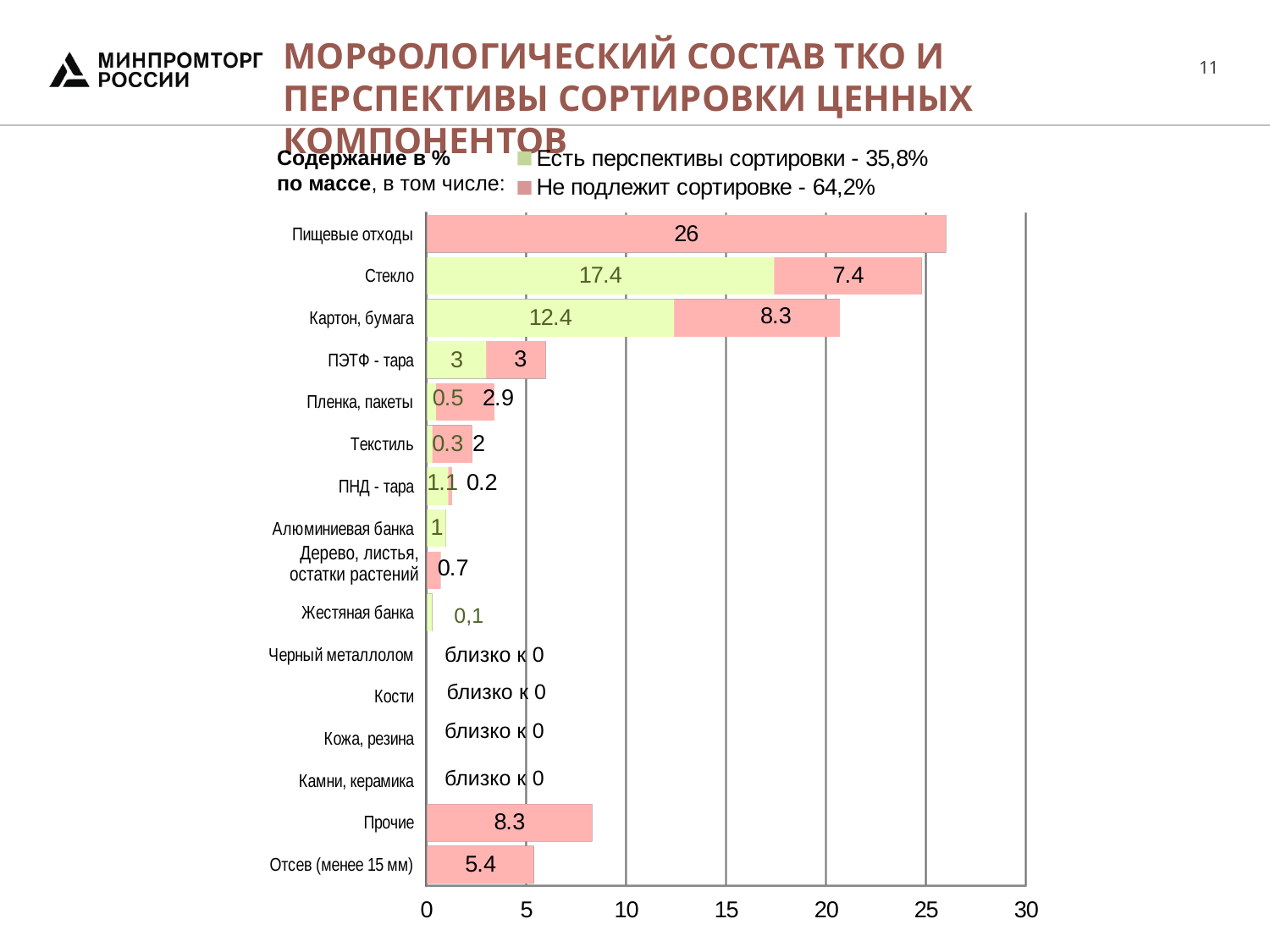
What percentage is shown in the legend for the Не подлежит сортировке series? 64,2% What is the value for Стекло in the Есть перспективы сортировки series? 17.4 Which is larger: the Не подлежит сортировке value for Пленка, пакеты or for Текстиль? Пленка, пакеты What is the difference between the Не подлежит сортировке values for Прочие and Отсев (менее 15 мм)? 2.9 How many series does the legend list? 2 What is the value for Пищевые отходы in the Не подлежит сортировке series? 26 What is the total of the stacked bar for Картон, бумага? 20.7 What is the total of the stacked bar for Стекло? 24.8 How many categories are shown on the vertical axis of the chart? 16 What kind of chart is shown on the slide? bar chart What is the value for Картон, бумага in the Не подлежит сортировке series? 8.3 Which category has the highest value in the Есть перспективы сортировки series? Стекло